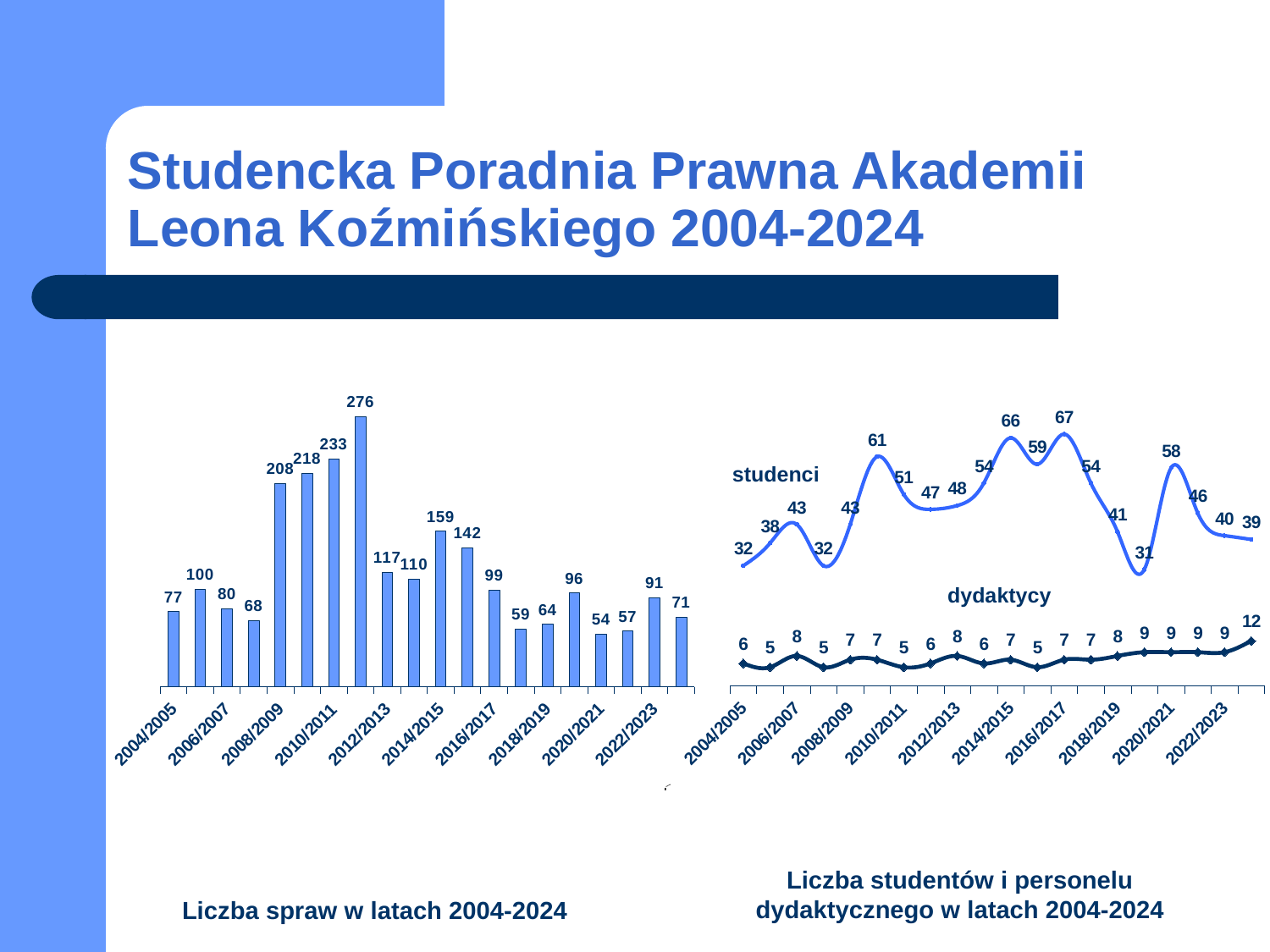
In the left chart 'Liczba spraw w latach 2004-2024', what is the lowest value shown? 54 In the left chart 'Liczba spraw w latach 2004-2024', what is the value for 2010/2011? 233 In the left chart 'Liczba spraw w latach 2004-2024', what is the highest value shown? 276 How many series are plotted in the right chart 'Liczba studentów i personelu dydaktycznego w latach 2004-2024'? 2 In the right chart 'Liczba studentów i personelu dydaktycznego w latach 2004-2024', what is the 'dydaktycy' value for 2020/2021? 9 In the left chart 'Liczba spraw w latach 2004-2024', what is the difference between the values for 2008/2009 and 2006/2007? 128 In the left chart 'Liczba spraw w latach 2004-2024', which is larger, the value for 2014/2015 or the value for 2016/2017? 2014/2015 What kind of chart is the left chart, 'Liczba spraw w latach 2004-2024'? bar chart In the right chart 'Liczba studentów i personelu dydaktycznego w latach 2004-2024', what is the highest 'dydaktycy' value? 12 In the right chart 'Liczba studentów i personelu dydaktycznego w latach 2004-2024', what is the 'studenci' value for 2016/2017? 67 How many bars are in the left chart 'Liczba spraw w latach 2004-2024'? 20 In the left chart 'Liczba spraw w latach 2004-2024', what is the value for 2004/2005? 77